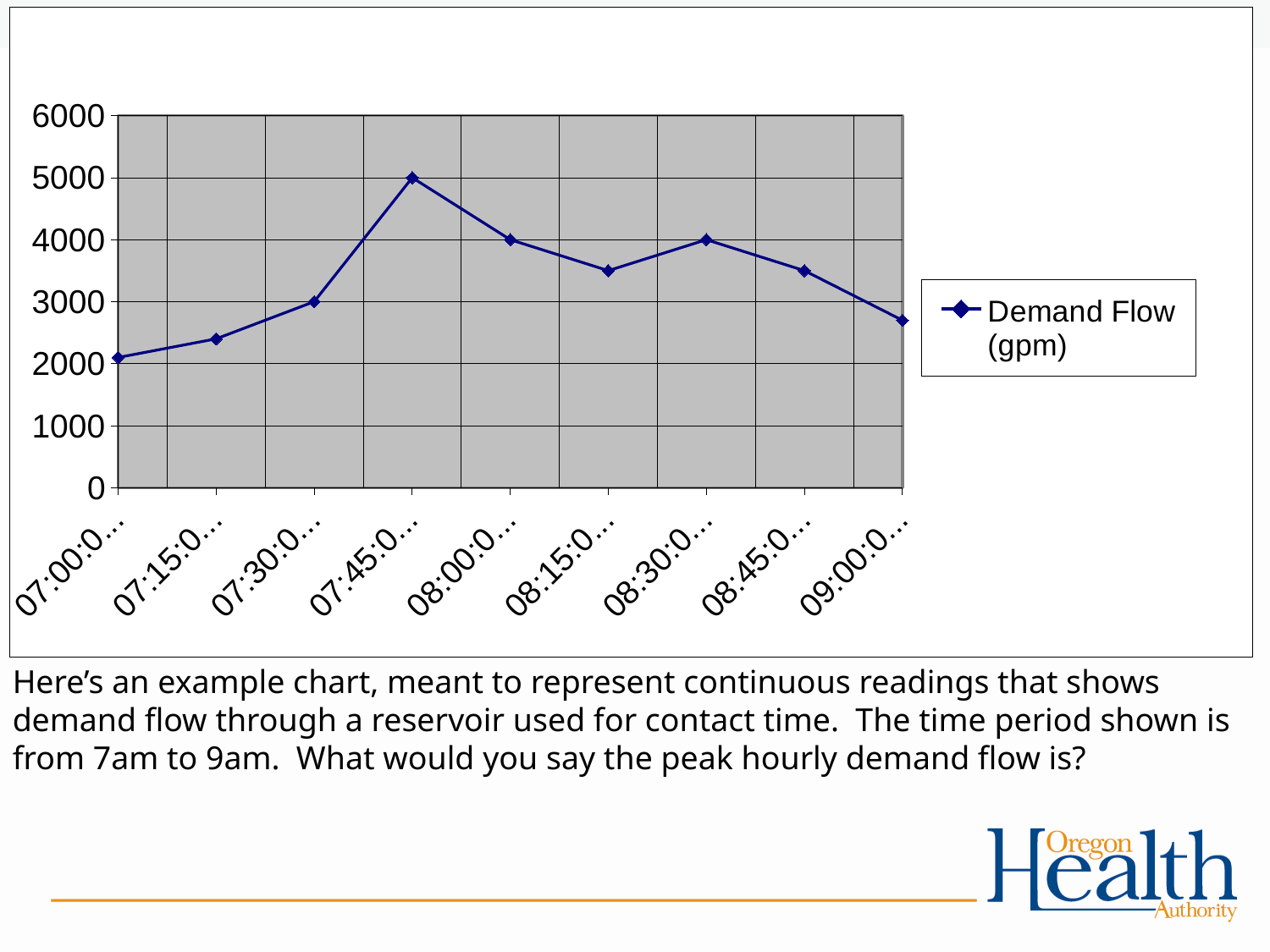
At which time is the demand flow lowest? 07:00 What is the difference between the demand flow at 07:45 and at 08:00? 1000 Is the demand flow at 08:15 greater or less than 4000? less What is the demand flow at 07:45? 5000 Which is larger, the demand flow at 08:00 or at 08:45? 08:00 What is the demand flow at 07:30? 3000 Does the demand flow rise or fall from 07:00 to 07:45? rise How many data points are plotted on the line? 9 What kind of chart is shown on the slide? line chart What is the demand flow at 08:00? 4000 At which time is the demand flow highest? 07:45 How many series does the legend list? 1